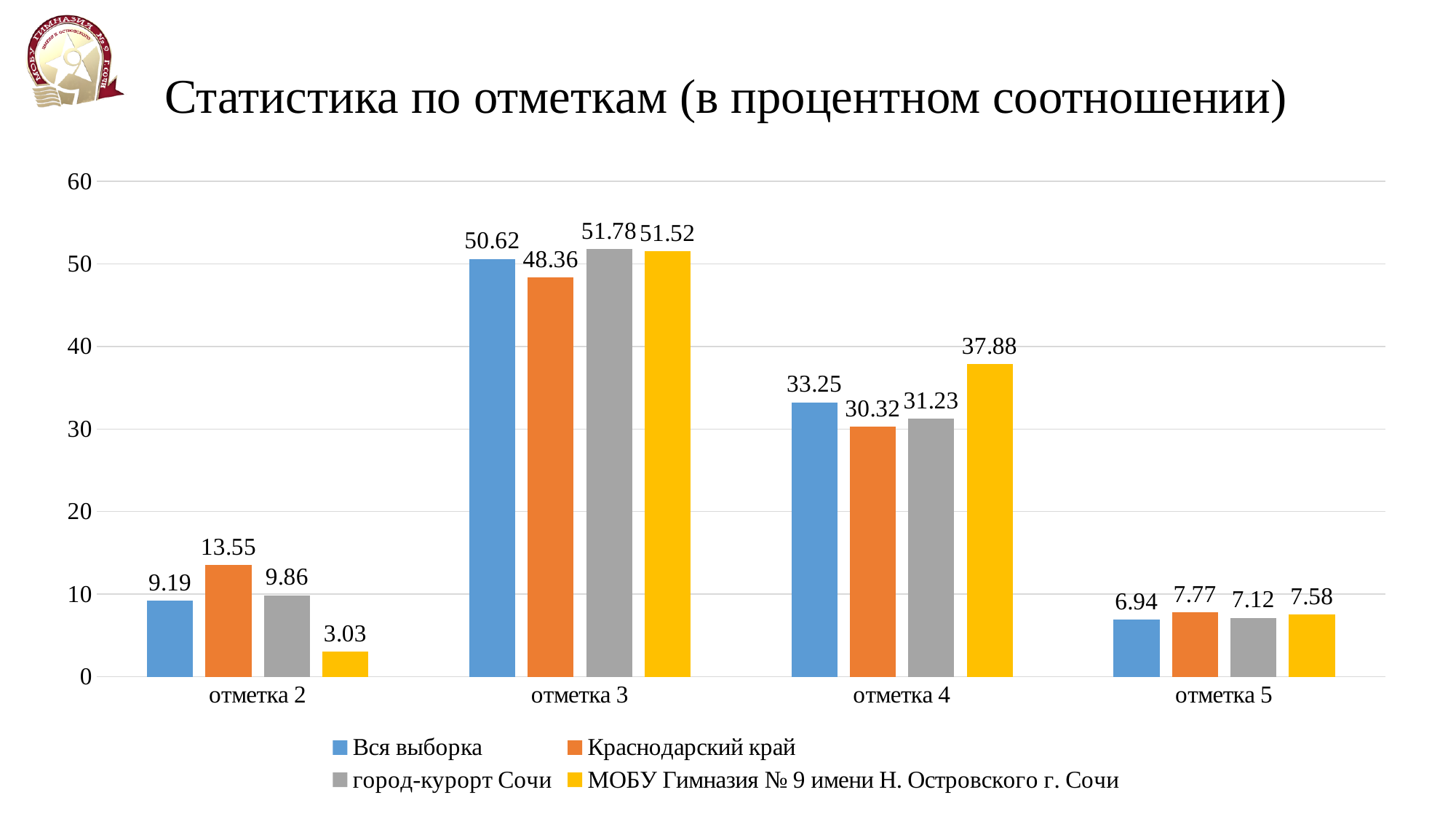
Which series has the lowest value at отметка 2? МОБУ Гимназия № 9 имени Н. Островского г. Сочи What kind of chart is shown on the slide? Bar chart Which series has the highest value at отметка 4? МОБУ Гимназия № 9 имени Н. Островского г. Сочи What is the value for Краснодарский край at отметка 5? 7.77 What is the value for город-курорт Сочи at отметка 4? 31.23 How many series does the legend list? 4 Which is larger at отметка 3: Вся выборка or Краснодарский край? Вся выборка What is the value for Вся выборка at отметка 3? 50.62 What is the value for МОБУ Гимназия № 9 имени Н. Островского г. Сочи at отметка 2? 3.03 What is the title of the chart? Статистика по отметкам (в процентном соотношении) How many categories are shown on the x axis? 4 What is the difference between the values for Краснодарский край and Вся выборка at отметка 2? 4.36